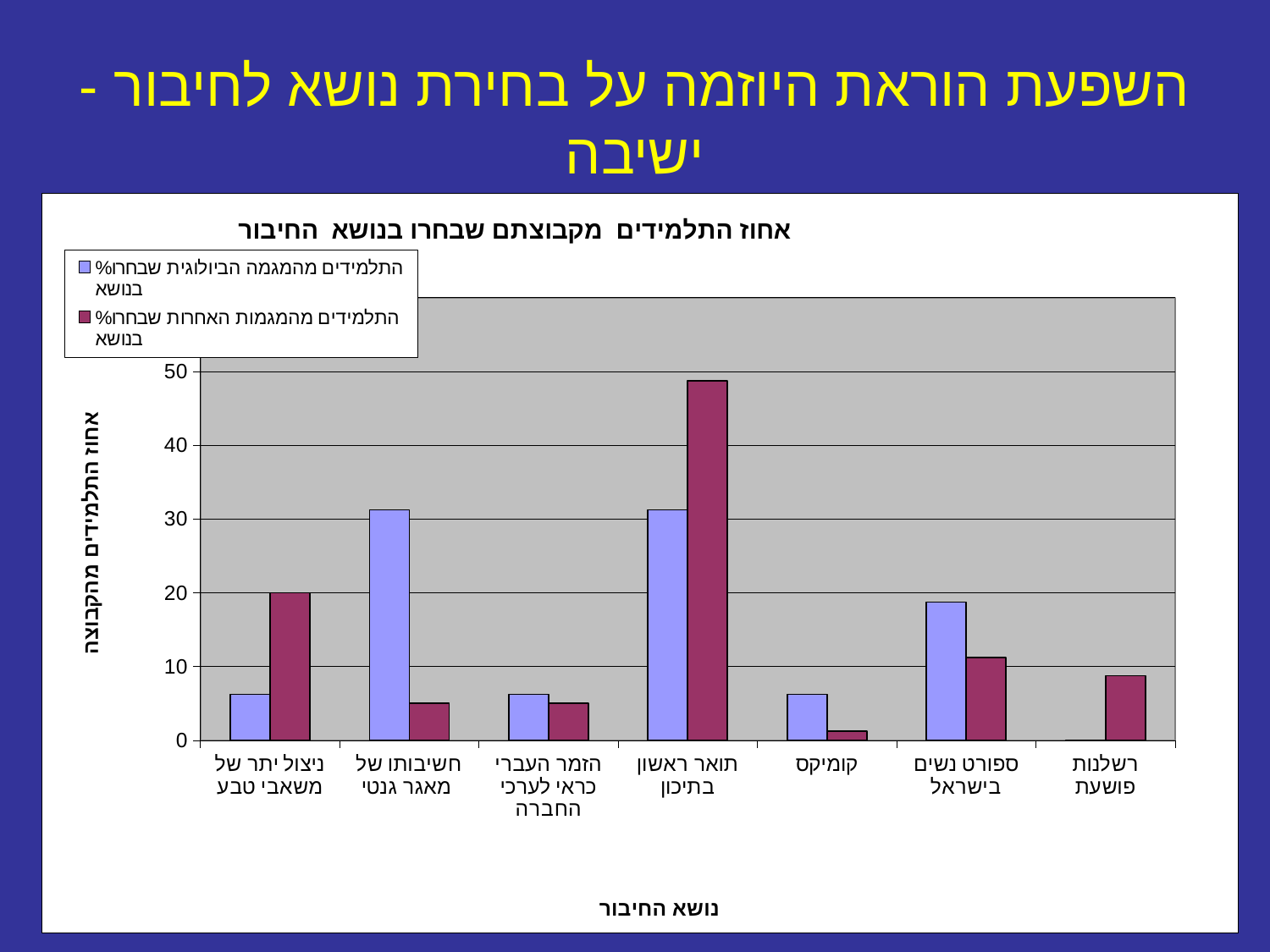
What kind of chart is shown on the slide? bar chart Is the value for 'תואר ראשון בתיכון' in the series '% התלמידים מהמגמות האחרות שבחרו בנושא' greater or less than 40? greater How many categories (essay topics) are shown on the x axis? 7 For 'ספורט נשים בישראל', which series has the larger value: '% התלמידים מהמגמה הביולוגית שבחרו בנושא' or '% התלמידים מהמגמות האחרות שבחרו בנושא'? % התלמידים מהמגמה הביולוגית שבחרו בנושא What is the label of the x axis? נושא החיבור For 'ניצול יתר של משאבי טבע', which series has the larger value: '% התלמידים מהמגמה הביולוגית שבחרו בנושא' or '% התלמידים מהמגמות האחרות שבחרו בנושא'? % התלמידים מהמגמות האחרות שבחרו בנושא Is the value for 'חשיבותו של מאגר גנטי' in the series '% התלמידים מהמגמה הביולוגית שבחרו בנושא' greater or less than 30? greater Which category has the highest value for the series '% התלמידים מהמגמות האחרות שבחרו בנושא'? תואר ראשון בתיכון How many series does the legend list? 2 Is the value for 'ספורט נשים בישראל' in the series '% התלמידים מהמגמות האחרות שבחרו בנושא' greater or less than 20? less What is the title of the chart? אחוז התלמידים מקבוצתם שבחרו בנושא החיבור